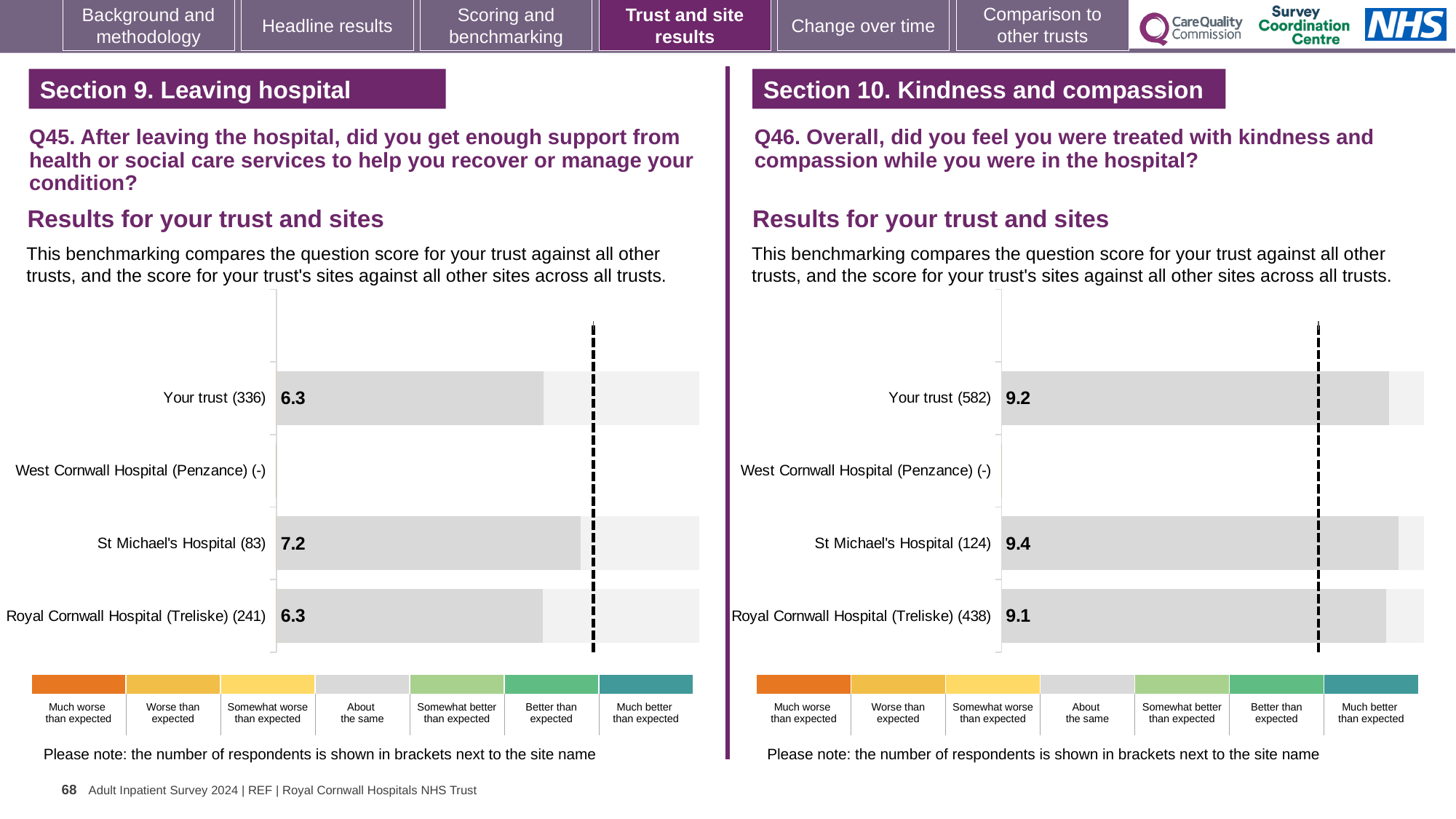
On the Q46 chart (right), what is the difference between the scores for St Michael's Hospital (124) and Your trust (582)? 0.2 On the Q46 chart (right), what is the score for Royal Cornwall Hospital (Treliske) (438)? 9.1 What kind of chart is used on the Q45 chart (left)? Bar chart On the Q45 chart (left), which site or trust row has the highest score? St Michael's Hospital (83) On the Q45 chart (left), how many rows (categories) are listed on the vertical axis? 4 On the Q46 chart (right), what is the score for Your trust (582)? 9.2 On the Q46 chart (right), which row shows no score value? West Cornwall Hospital (Penzance) (-) On the Q45 chart (left), what is the score for Your trust (336)? 6.3 On the Q45 chart (left), what is the difference between the scores for St Michael's Hospital (83) and Royal Cornwall Hospital (Treliske) (241)? 0.9 On the Q45 chart (left), what is the score for St Michael's Hospital (83)? 7.2 On the Q46 chart (right), which site or trust row has the highest score? St Michael's Hospital (124) On the Q46 chart (right), which is larger: the score for Your trust (582) or for Royal Cornwall Hospital (Treliske) (438)? Your trust (582)